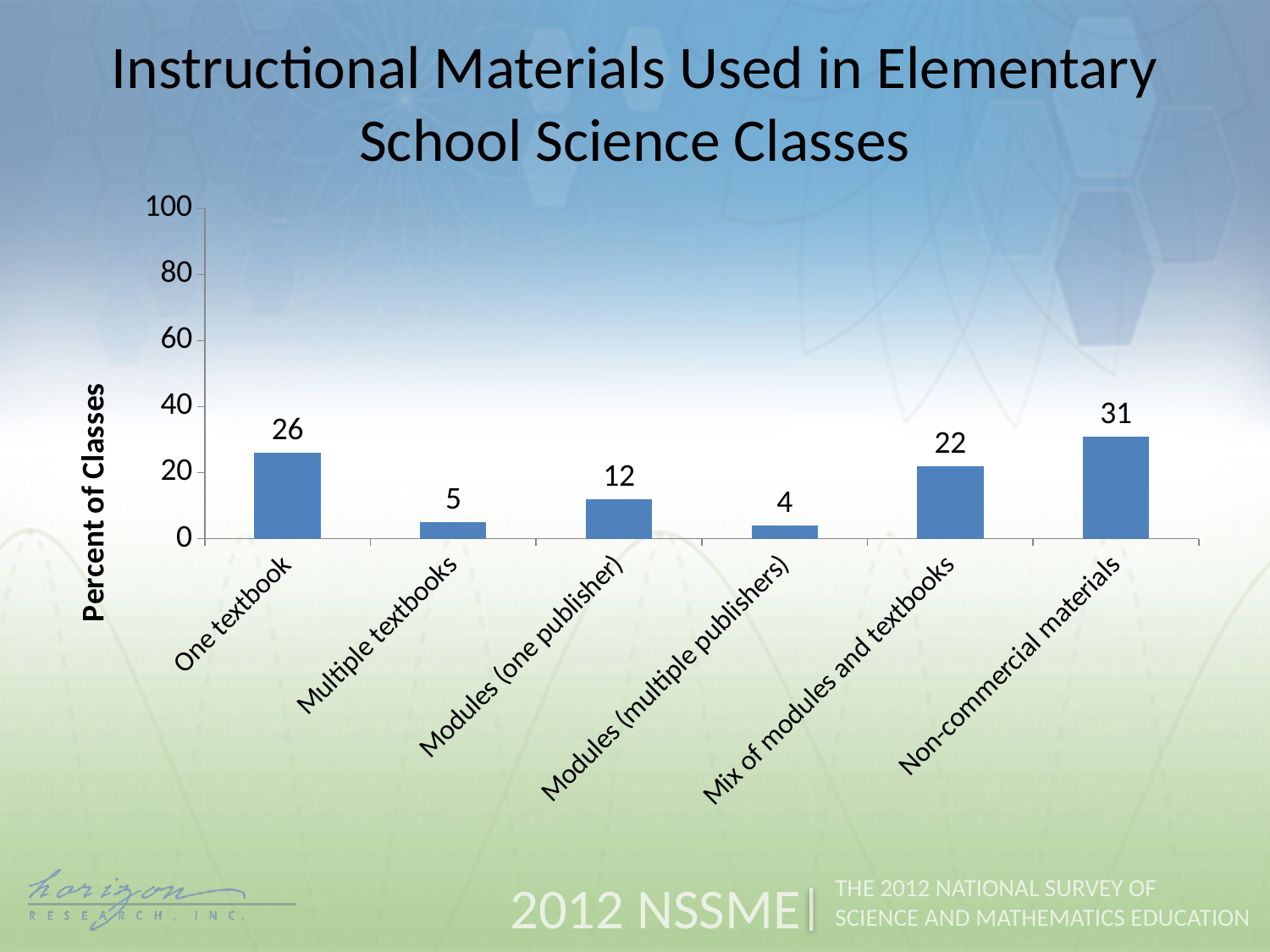
What is the value for Mix of modules and textbooks? 22 What is the value for One textbook? 26 Which category has the lowest value? Modules (multiple publishers) Which is larger, the value for One textbook or the value for Mix of modules and textbooks? One textbook Is the value for Non-commercial materials greater or less than 40? less What is the difference between the values for Non-commercial materials and One textbook? 5 Which category has the highest value? Non-commercial materials What is the difference between the values for Modules (one publisher) and Multiple textbooks? 7 How many categories are shown on the x axis? 6 What is the label of the vertical axis? Percent of Classes What is the value for Modules (multiple publishers)? 4 What kind of chart is shown on the slide? bar chart